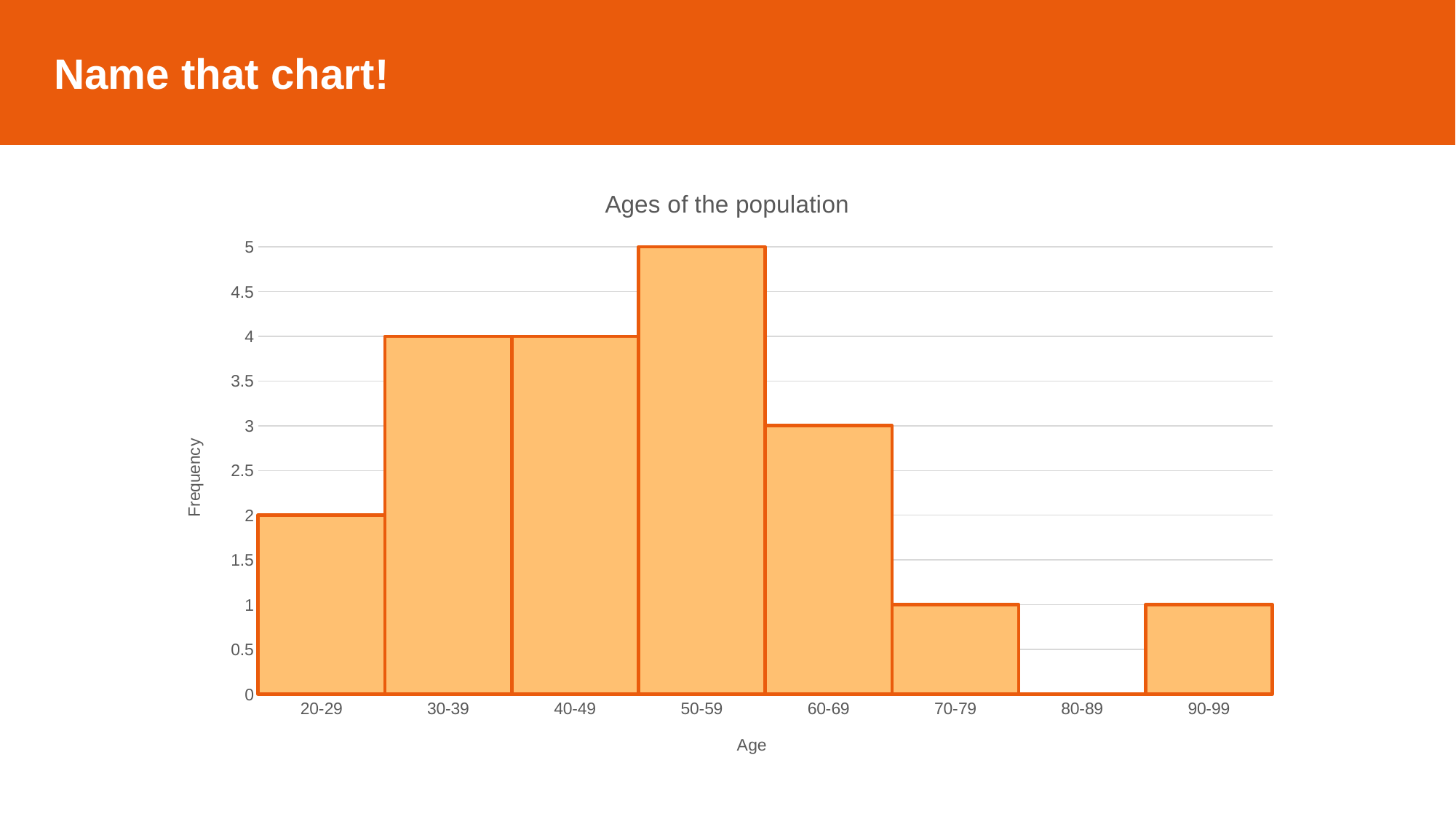
What is the frequency for the 80-89 age group? 0 Is the frequency for the 60-69 age group greater or less than 2.5? greater What is the frequency for the 20-29 age group? 2 What is the frequency for the 50-59 age group? 5 Which age group has the lowest frequency? 80-89 How many age groups are shown on the x axis? 8 Which has a higher frequency, the 30-39 age group or the 60-69 age group? 30-39 What is the difference in frequency between the 50-59 and 20-29 age groups? 3 What kind of chart is shown on the slide? bar chart What is the title of the chart? Ages of the population What is the frequency for the 60-69 age group? 3 Which age group has the highest frequency? 50-59